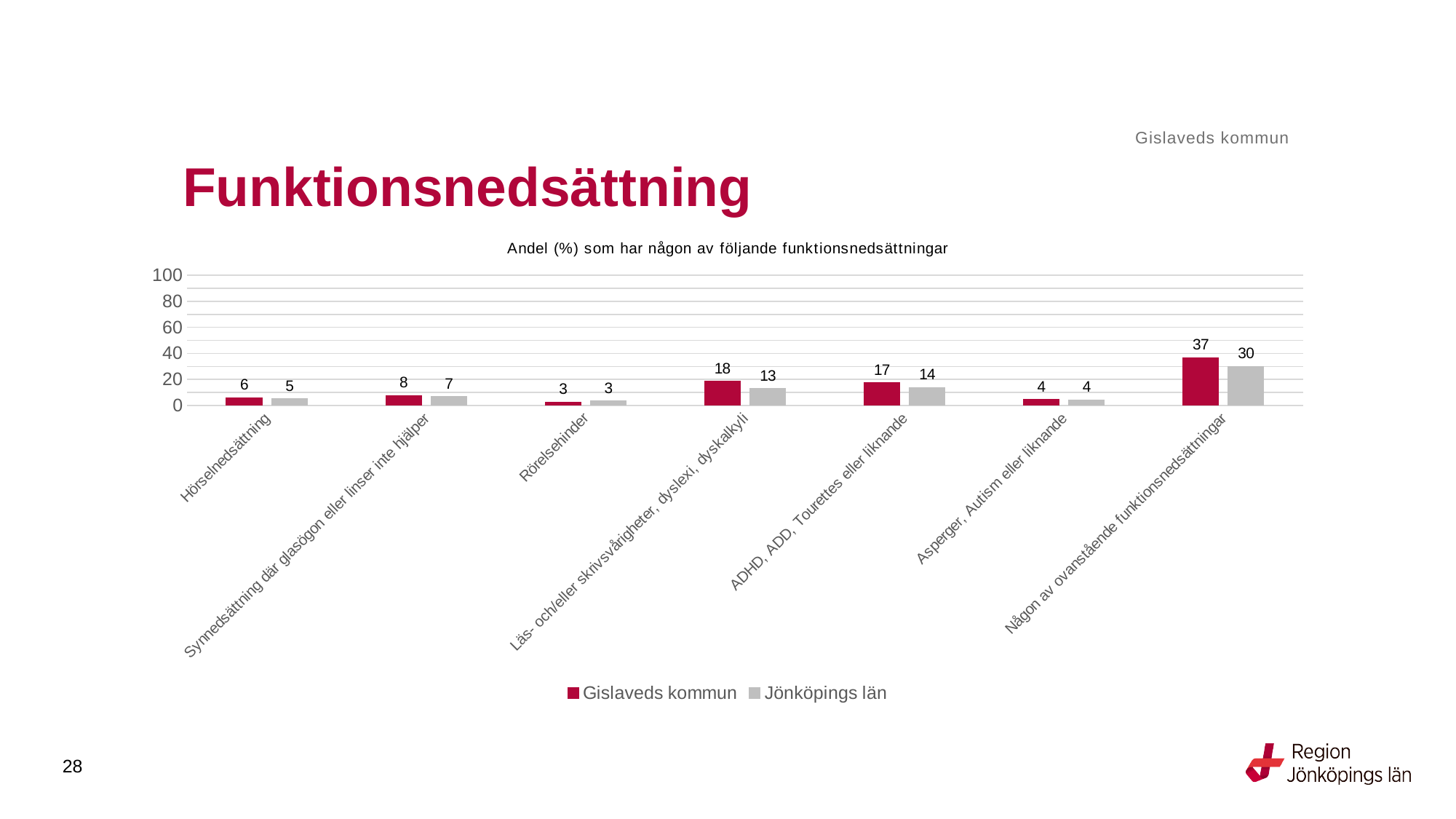
Which is larger for Läs- och/eller skrivsvårigheter, dyslexi, dyskalkyli: Gislaveds kommun or Jönköpings län? Gislaveds kommun How many categories are shown on the x axis? 7 What is the difference between Gislaveds kommun and Jönköpings län for Någon av ovanstående funktionsnedsättningar? 7 Is the value for Gislaveds kommun for Någon av ovanstående funktionsnedsättningar greater or less than 20? greater Which category has the highest value for Gislaveds kommun? Någon av ovanstående funktionsnedsättningar What is the value for Gislaveds kommun for Läs- och/eller skrivsvårigheter, dyslexi, dyskalkyli? 18 What is the title of the chart? Andel (%) som har någon av följande funktionsnedsättningar How many series does the legend list? 2 Which category has the lowest value for Jönköpings län? Rörelsehinder What kind of chart is shown on the slide? Bar chart What is the value for Gislaveds kommun for Hörselnedsättning? 6 What is the value for Jönköpings län for ADHD, ADD, Tourettes eller liknande? 14